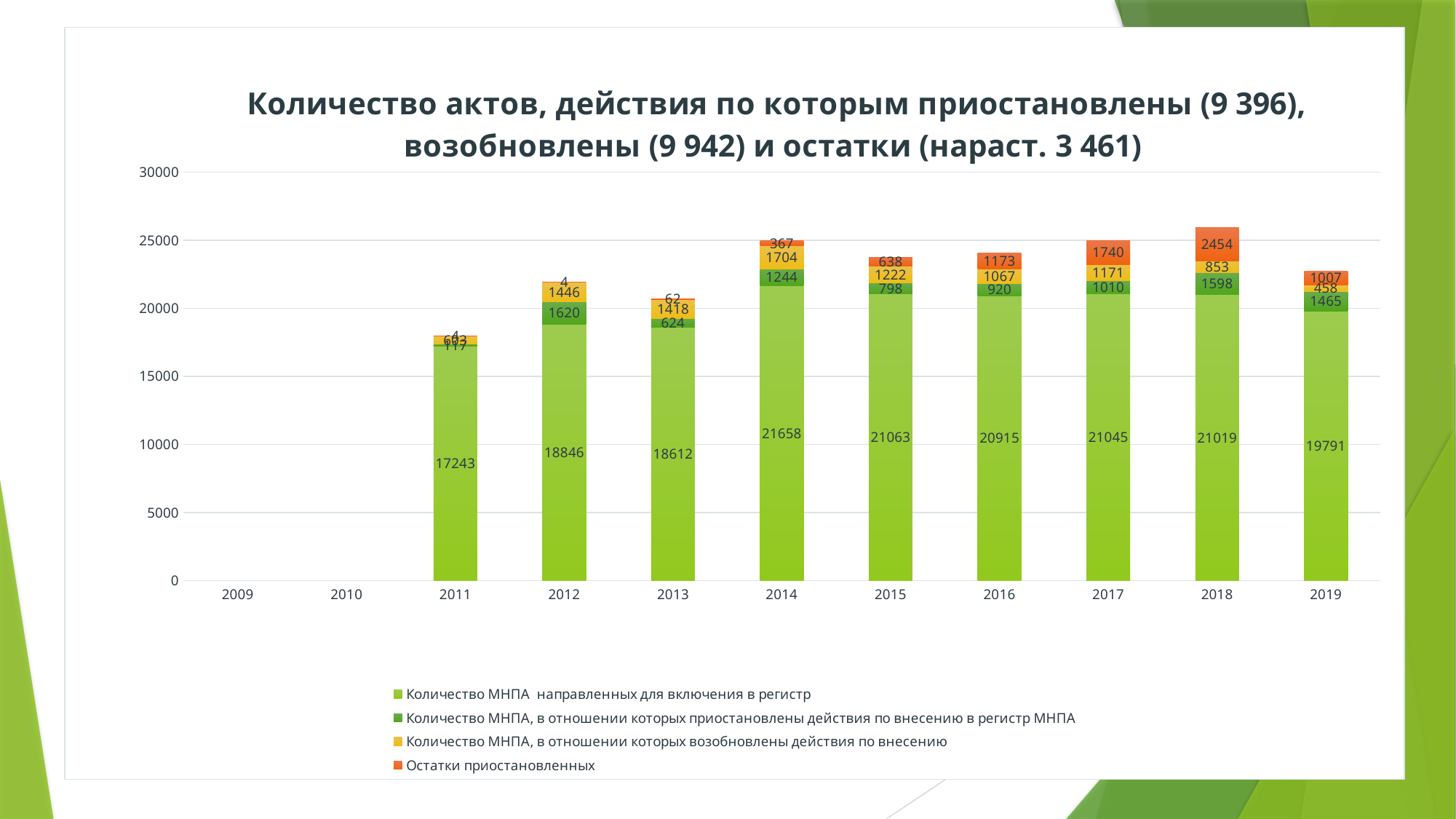
What is the value of the 'Остатки приостановленных' series for 2018? 2454 In which year is the 'Количество МНПА направленных для включения в регистр' value the highest? 2014 How many years on the x axis have bars plotted? 9 Which year has the larger 'Количество МНПА направленных для включения в регистр' value, 2014 or 2019? 2014 Among the years with bars, in which year is the 'Количество МНПА направленных для включения в регистр' value the lowest? 2011 How many series does the legend list? 4 What is the value of the 'Количество МНПА направленных для включения в регистр' series for 2014? 21658 What kind of chart is shown on the slide? Stacked bar chart Is the total height of the 2011 stacked bar greater or less than 20000? less What is the difference between the 'Остатки приостановленных' values for 2018 and 2017? 714 What is the total of the stacked bar for 2019? 22721 What is the value of the 'Количество МНПА, в отношении которых приостановлены действия по внесению в регистр МНПА' series for 2018? 1598